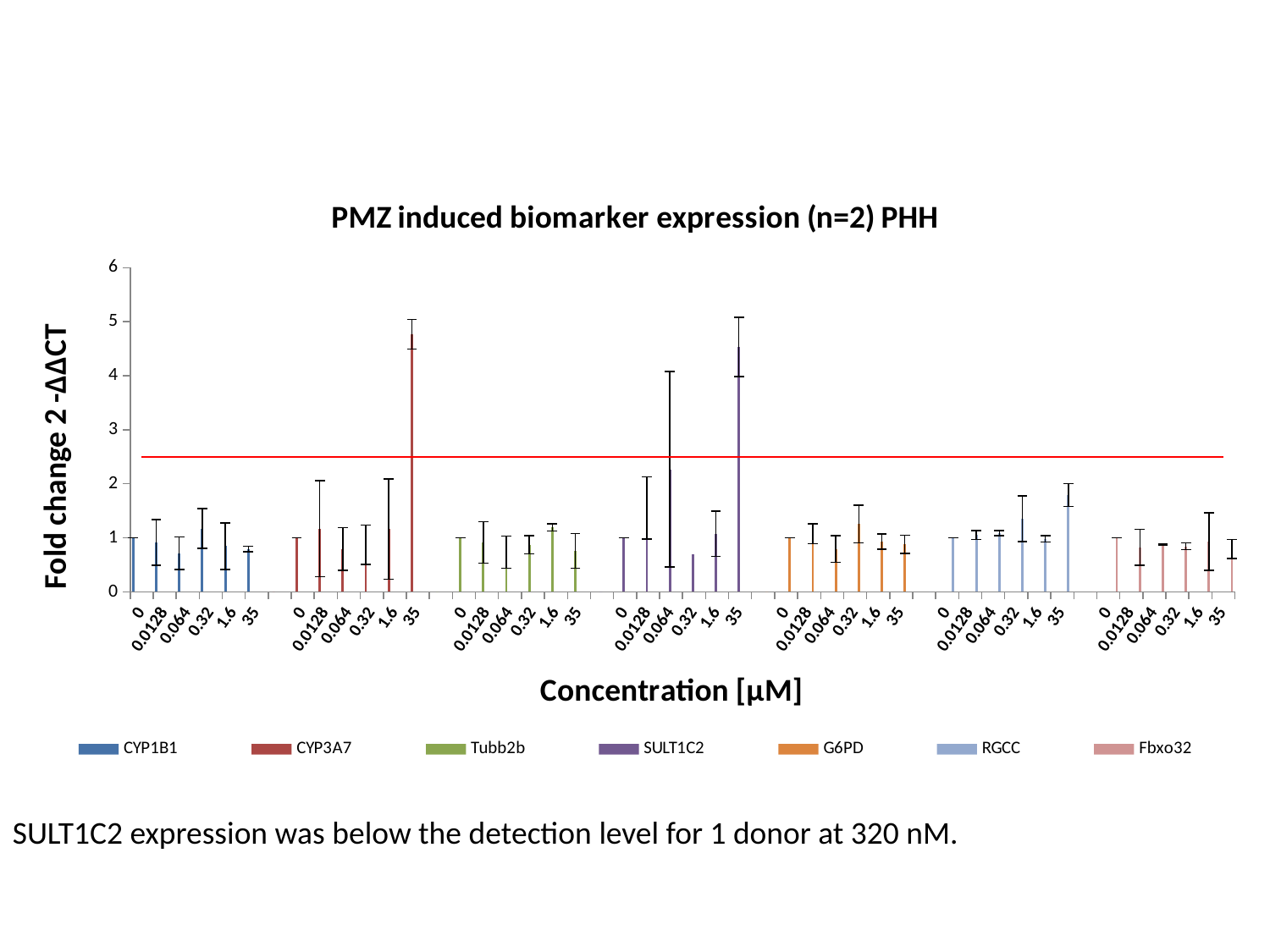
Within the CYP3A7 series, which concentration has the highest value? 35 Is the value for CYP3A7 at 35 µM greater or less than 4? greater What is the label of the x axis? Concentration [µM] Within the SULT1C2 series, which concentration has the highest value? 35 Is the value for Fbxo32 at 0.0128 µM greater or less than 1? less Is the value for RGCC at 35 µM greater or less than 2? less How many concentration levels are plotted for each biomarker series? 6 What kind of chart is shown on the slide? bar chart Which is larger: the Tubb2b value at 1.6 µM or at 0.0128 µM? 1.6 µM How many series does the legend list? 7 What is the title of the chart? PMZ induced biomarker expression (n=2) PHH